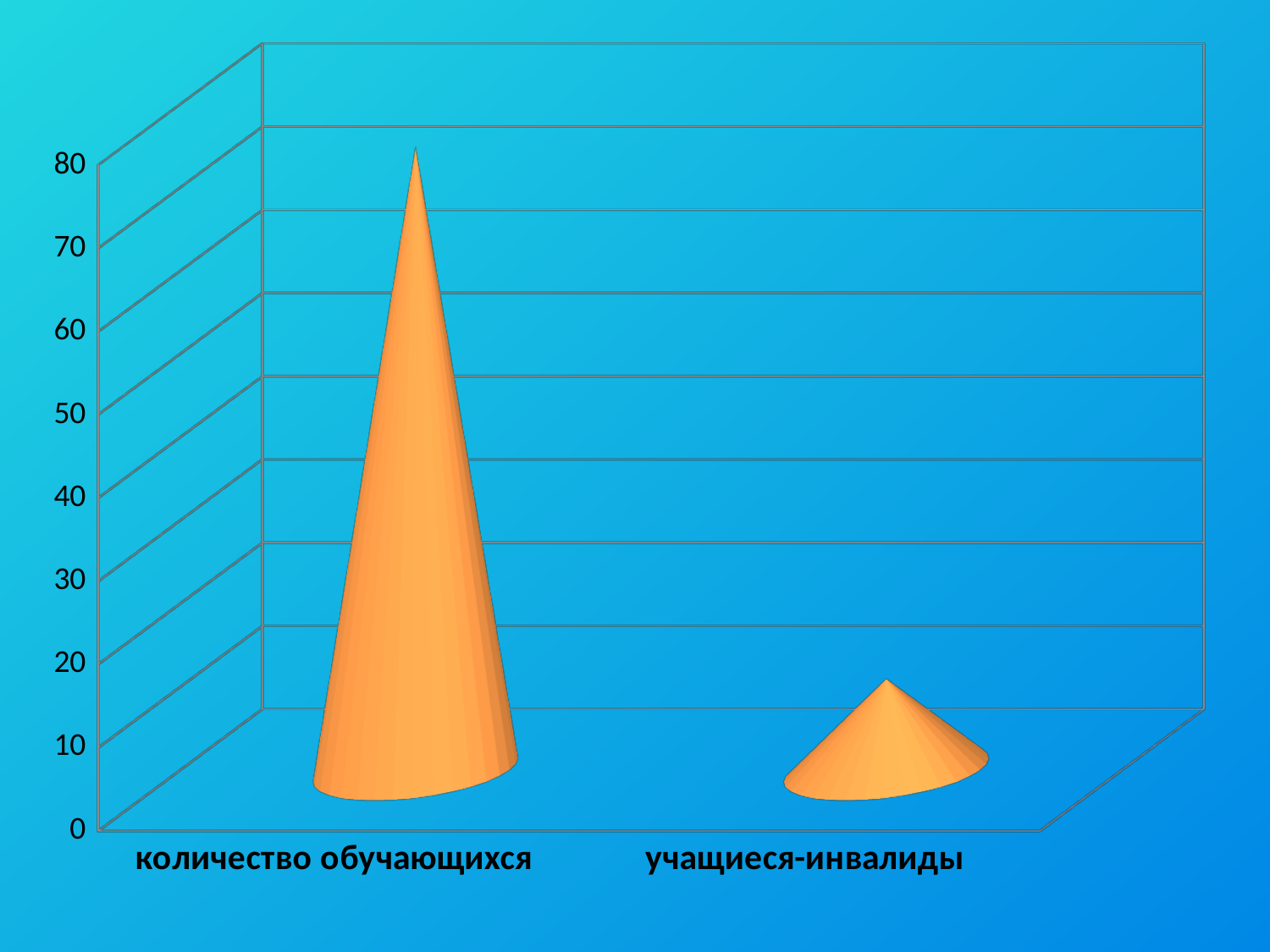
Which category has the lowest value in the chart? учащиеся-инвалиды How many categories are shown on the x axis of the chart? 2 What kind of chart is shown on the slide? bar chart Is the value for количество обучающихся greater or less than 50? greater Which category has the highest value in the chart? количество обучающихся Is the value for количество обучающихся greater or less than 40? greater Is the value for учащиеся-инвалиды greater or less than 30? less What is the highest value shown on the vertical axis of the chart? 80 Which is larger, the value for количество обучающихся or the value for учащиеся-инвалиды? количество обучающихся What colour are the bars in the chart? orange Do the values fall or rise from the first category to the second along the x axis? fall